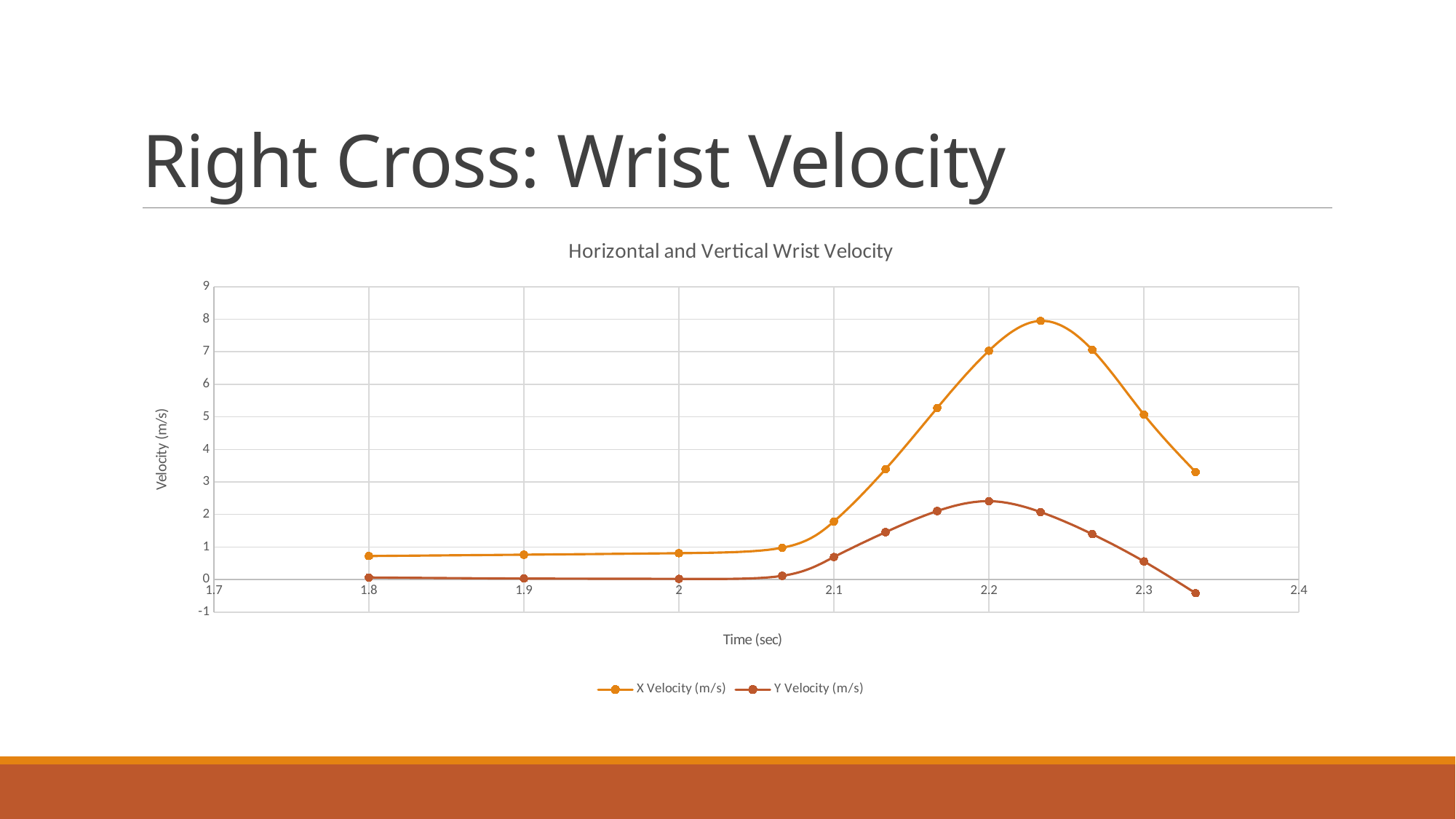
How many series does the legend list? 2 Is the X Velocity (m/s) value at time 2.1 greater or less than 1? greater What kind of chart is shown on the slide? line chart What is the label of the x axis? Time (sec) Is the X Velocity (m/s) value at time 1.8 greater or less than 1? less At time 2.2, which series has the larger value, X Velocity (m/s) or Y Velocity (m/s)? X Velocity (m/s) How many data points are plotted for the X Velocity (m/s) series? 12 Is the Y Velocity (m/s) value at time 2.2 greater or less than 2? greater Does the X Velocity (m/s) series rise or fall between time 2.1 and time 2.2? rise What is the title of the chart? Horizontal and Vertical Wrist Velocity Which series reaches the highest peak value on the chart? X Velocity (m/s)